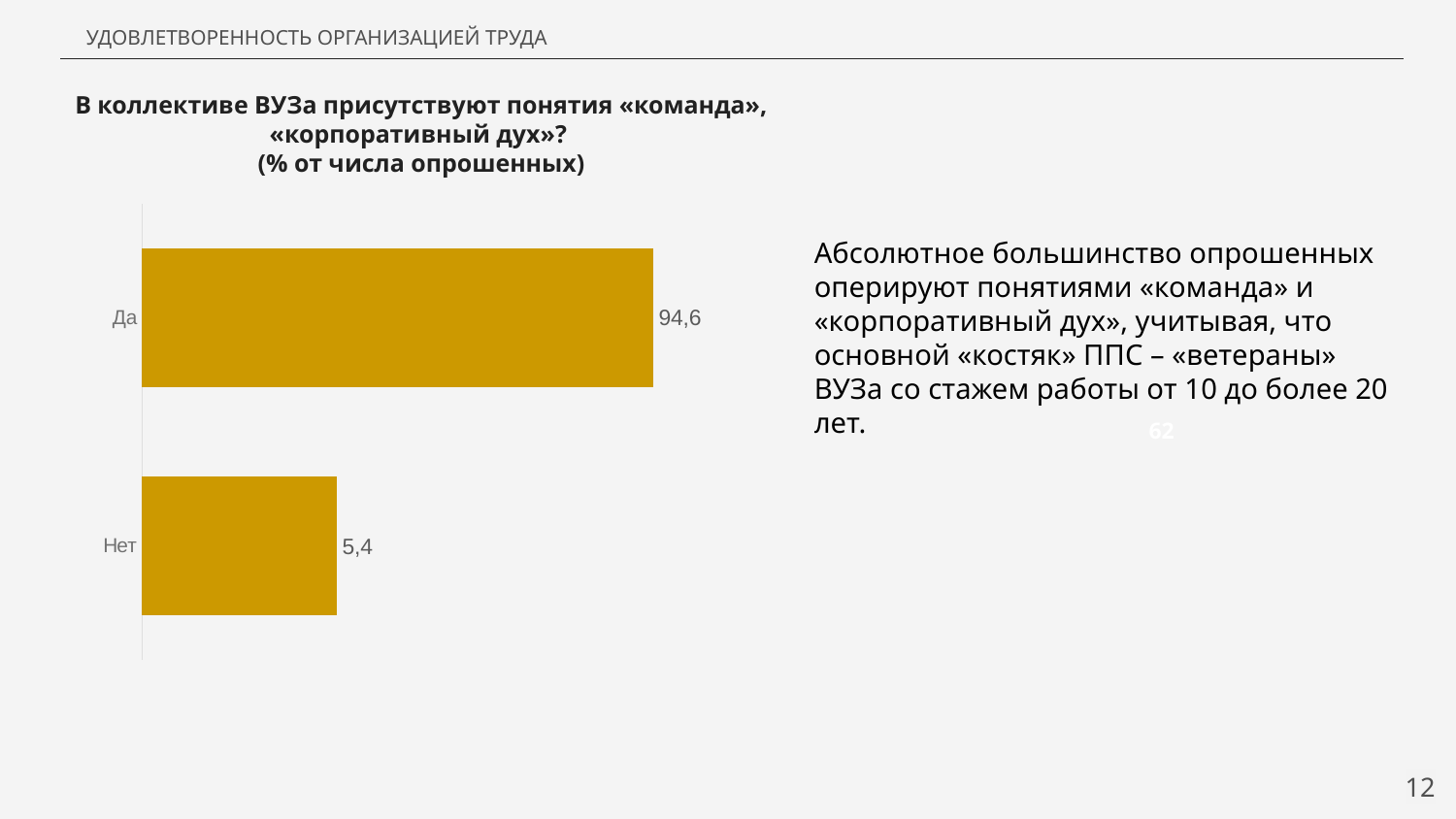
What is the difference between the values for «Да» and «Нет»? 89,2 What unit are the chart values expressed in, according to the chart title? % от числа опрошенных Which category has the lowest value? Нет Which is larger, the value for «Да» or the value for «Нет»? Да What is the value for «Нет»? 5,4 How many categories are shown in the chart? 2 What is the value for «Да»? 94,6 Which category has the highest value? Да What kind of chart is shown on the slide? Bar chart What is the total of the two values shown in the chart? 100 What colour are the bars in the chart? Yellow (gold)